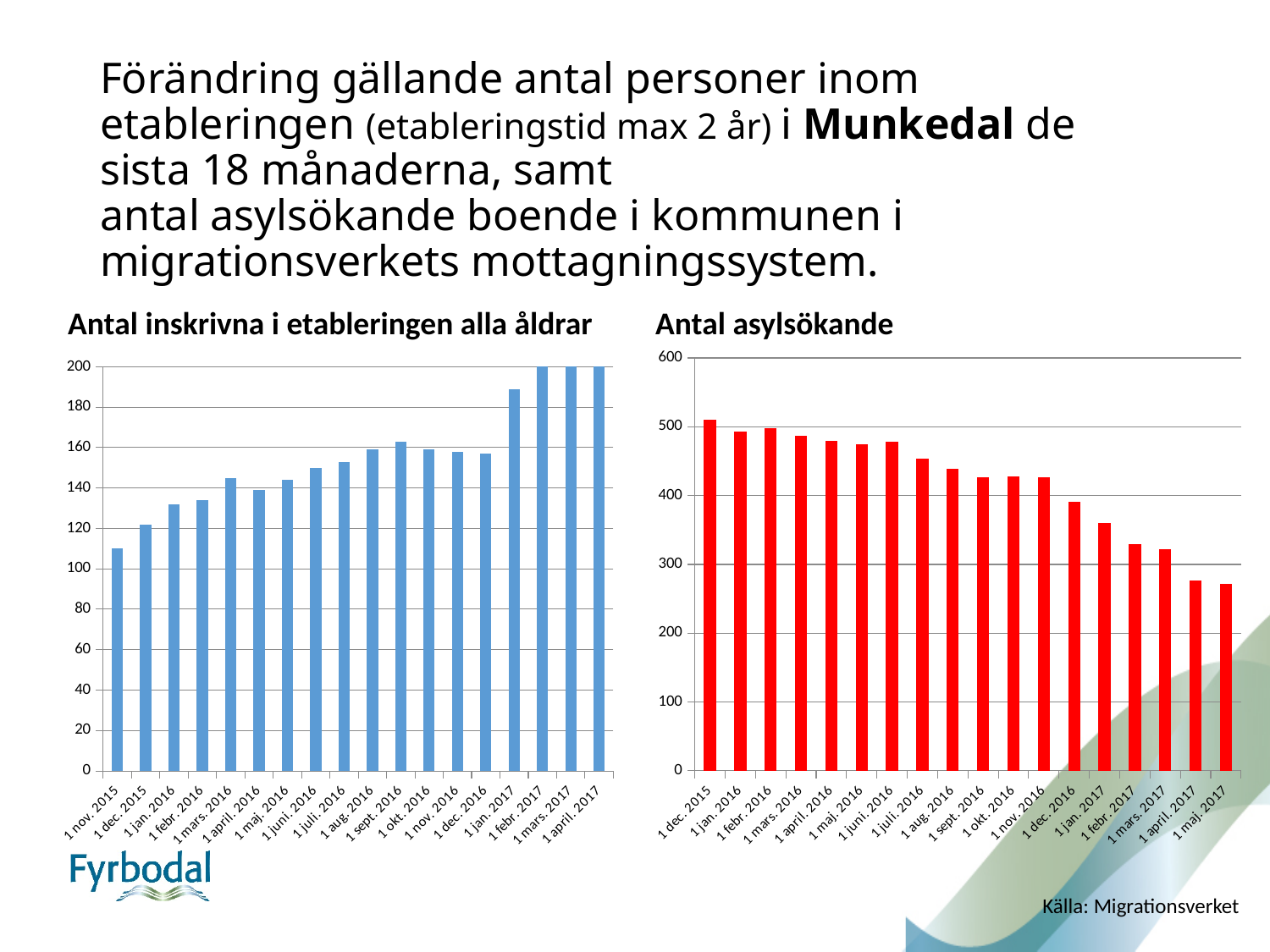
What type of chart is the "Antal inskrivna i etableringen alla åldrar" chart? bar chart In the "Antal inskrivna i etableringen alla åldrar" chart, do the values generally rise or fall from 1 nov. 2015 to 1 april 2017? rise How many bars are plotted in the "Antal inskrivna i etableringen alla åldrar" chart? 18 What colour are the bars in the "Antal asylsökande" chart? red In the "Antal asylsökande" chart, which date has the highest value? 1 dec. 2015 In the "Antal asylsökande" chart, is the value for 1 maj 2017 greater or less than 300? less In the "Antal inskrivna i etableringen alla åldrar" chart, which is larger: the value for 1 sept. 2016 or the value for 1 april 2016? 1 sept. 2016 In the "Antal asylsökande" chart, is the value for 1 dec. 2016 greater or less than 400? less In the "Antal asylsökande" chart, do the values generally rise or fall from left to right along the x axis? fall In the "Antal inskrivna i etableringen alla åldrar" chart, which date has the lowest value? 1 nov. 2015 How many dates are shown on the x axis of the "Antal asylsökande" chart? 18 In the "Antal inskrivna i etableringen alla åldrar" chart, is the value for 1 jan. 2017 greater or less than 180? greater